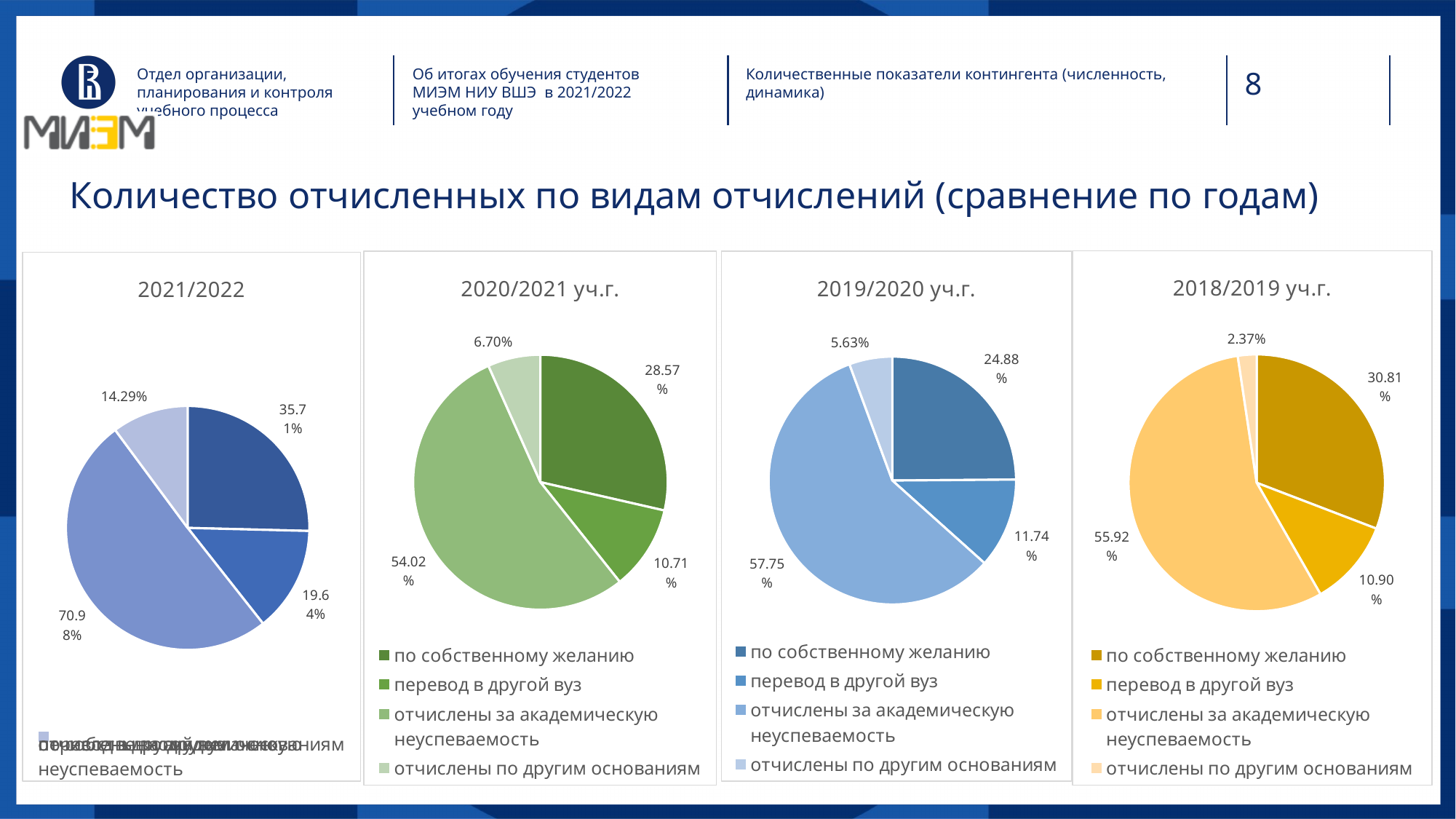
In the 2019/2020 уч.г. chart, what share is labelled for 'перевод в другой вуз'? 11.74% In the 2018/2019 уч.г. chart, what is the difference between the shares for 'по собственному желанию' and 'перевод в другой вуз'? 19.91% In the 2019/2020 уч.г. chart, which is larger: the share for 'по собственному желанию' or for 'перевод в другой вуз'? по собственному желанию How many entries does the legend of the 2019/2020 уч.г. chart list? 4 In the 2020/2021 уч.г. chart, what share is labelled for 'по собственному желанию'? 28.57% In the 2019/2020 уч.г. chart, which category has the smallest slice? отчислены по другим основаниям What type of chart is used for the 2020/2021 уч.г. data? pie chart How many pie charts are shown on the slide? 4 In the 2018/2019 уч.г. chart, which category has the largest slice? отчислены за академическую неуспеваемость In the 2020/2021 уч.г. chart, what share is labelled for 'отчислены за академическую неуспеваемость'? 54.02% What is the largest percentage labelled on the 2021/2022 chart? 70.98%